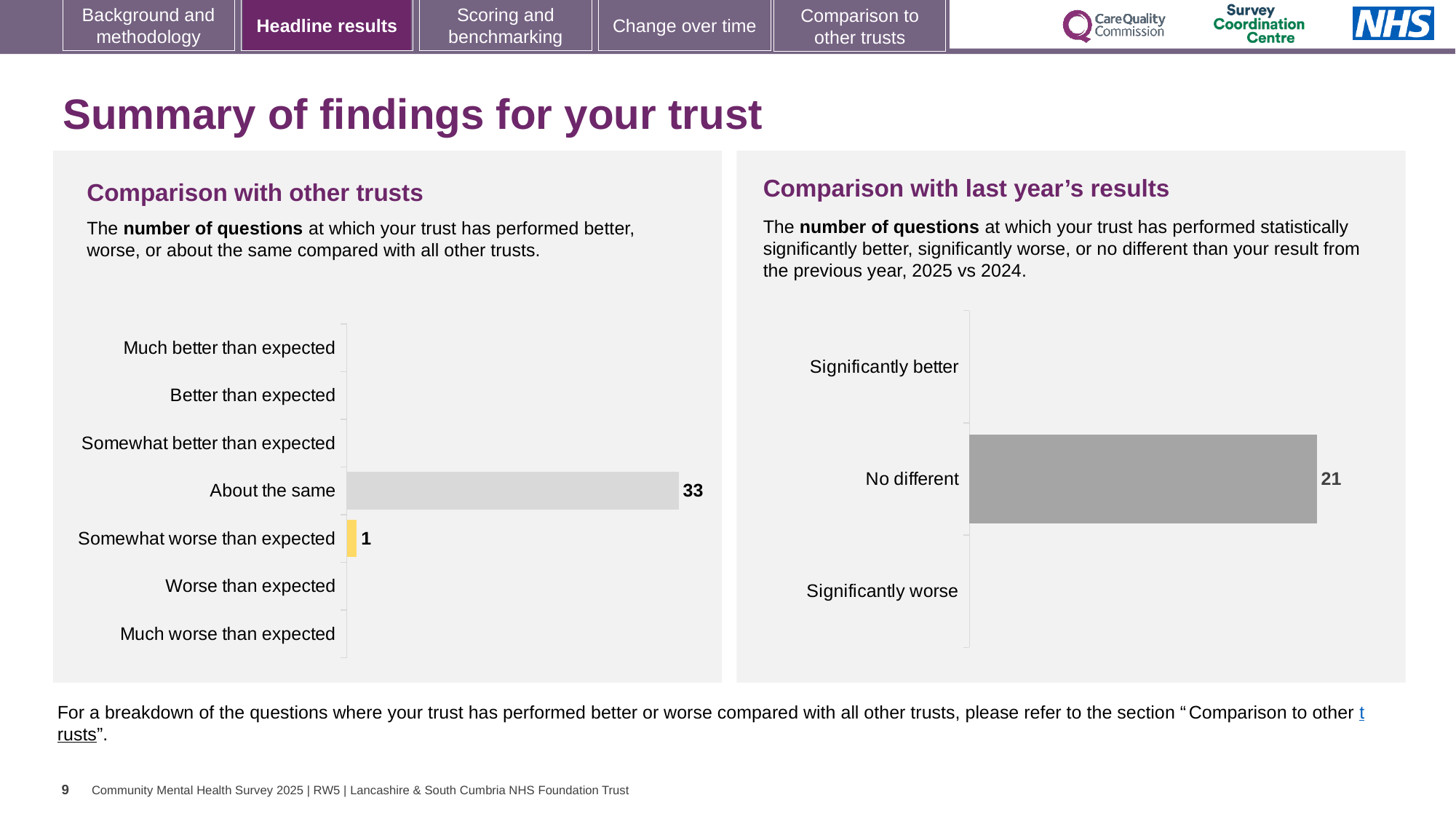
What is the title of the chart on the right side of the slide? Comparison with last year's results In the 'Comparison with other trusts' chart, what is the difference between the 'About the same' and 'Somewhat worse than expected' values? 32 In the 'Comparison with other trusts' chart, how many questions are labelled 'Somewhat worse than expected'? 1 In the 'Comparison with other trusts' chart, how many questions are labelled 'About the same'? 33 In the 'Comparison with last year's results' chart, how many questions are labelled 'No different'? 21 In the 'Comparison with other trusts' chart, how many categories are listed on the axis? 7 In the 'Comparison with other trusts' chart, which category has the highest number of questions? About the same In the 'Comparison with other trusts' chart, what colour is the bar for 'Somewhat worse than expected'? Yellow In the 'Comparison with last year's results' chart, how many categories are listed on the axis? 3 Which is larger: the 'About the same' value in the 'Comparison with other trusts' chart or the 'No different' value in the 'Comparison with last year's results' chart? About the same In the 'Comparison with last year's results' chart, which category has the highest number of questions? No different What type of chart is the 'Comparison with other trusts' chart? Bar chart